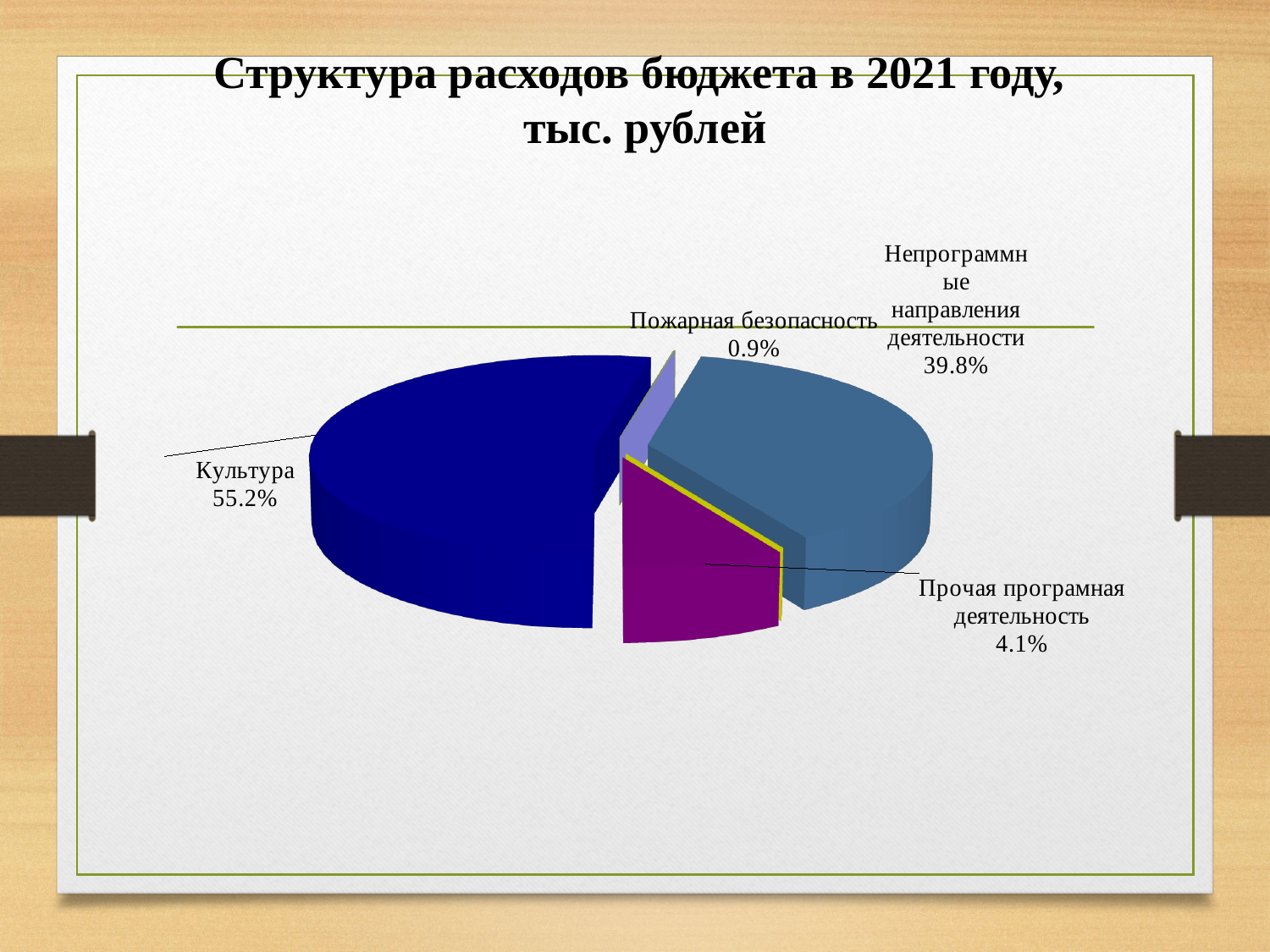
What kind of chart is shown on the slide? Pie chart What is the title of the chart? Структура расходов бюджета в 2021 году, тыс. рублей What colour is the slice for Прочая програмная деятельность? Purple What is the difference in percentage points between Культура and Непрограммные направления деятельности? 15.4 What is the value shown for Непрограммные направления деятельности? 39.8% Which category has the largest share of the pie? Культура What is the value shown for Прочая програмная деятельность? 4.1% Which category has the smallest share of the pie? Пожарная безопасность What share of the pie does Культура represent? 55.2% What is the value shown for Пожарная безопасность? 0.9% Which is larger: Прочая програмная деятельность or Пожарная безопасность? Прочая програмная деятельность How many slices does the pie chart have? 4